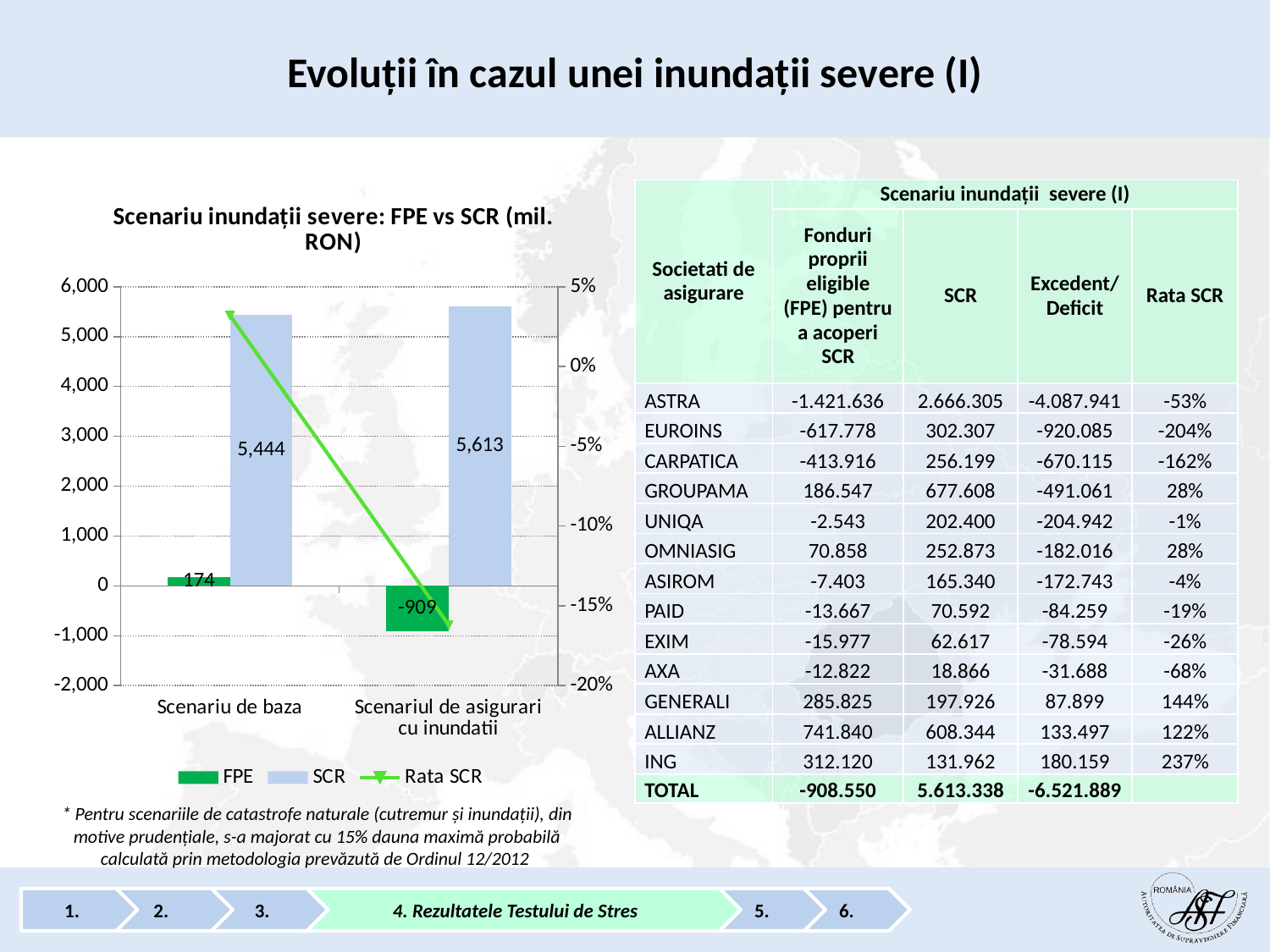
How many scenarios (categories) are shown on the x axis of the chart? 2 Is the Rata SCR value for Scenariu de baza greater or less than 0%? greater What is the FPE value for Scenariu de baza? 174 By how much does SCR in Scenariul de asigurari cu inundatii exceed SCR in Scenariu de baza? 169 Is the Rata SCR value for Scenariul de asigurari cu inundatii greater or less than -10%? less What is the SCR value for Scenariul de asigurari cu inundatii? 5,613 Which scenario has the larger SCR value? Scenariul de asigurari cu inundatii What is the FPE value for Scenariul de asigurari cu inundatii? -909 How many series does the chart legend list? 3 What is the difference between the FPE value in Scenariu de baza and the FPE value in Scenariul de asigurari cu inundatii? 1,083 What is the SCR value for Scenariu de baza? 5,444 Does the FPE value rise or fall from Scenariu de baza to Scenariul de asigurari cu inundatii? fall